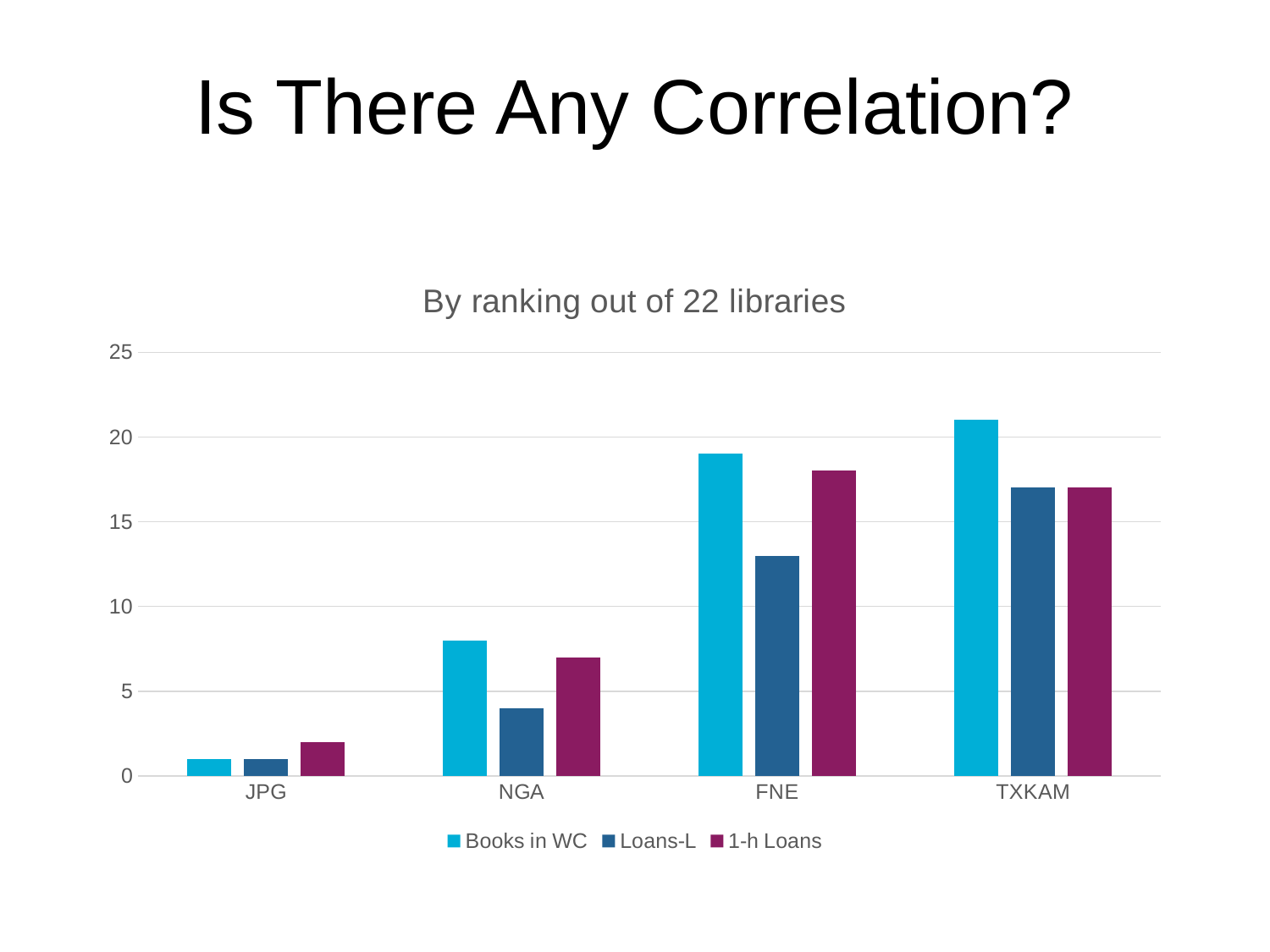
How many libraries (categories) are shown on the x axis? 4 What is the subtitle shown above the chart? By ranking out of 22 libraries Is the Books in WC value for TXKAM greater or less than 20? greater Which is larger for FNE: the Books in WC bar or the Loans-L bar? Books in WC Do the Books in WC values rise or fall moving from JPG to TXKAM along the x axis? rise What kind of chart is shown on the slide? bar chart Which library has the highest Books in WC ranking bar? TXKAM Is the Loans-L value for FNE greater or less than 15? less Is the 1-h Loans value for NGA greater or less than 5? greater How many series does the legend list? 3 Which library has the lowest Loans-L bar? JPG Which series is shown in the darkest (purple) colour in the legend? 1-h Loans